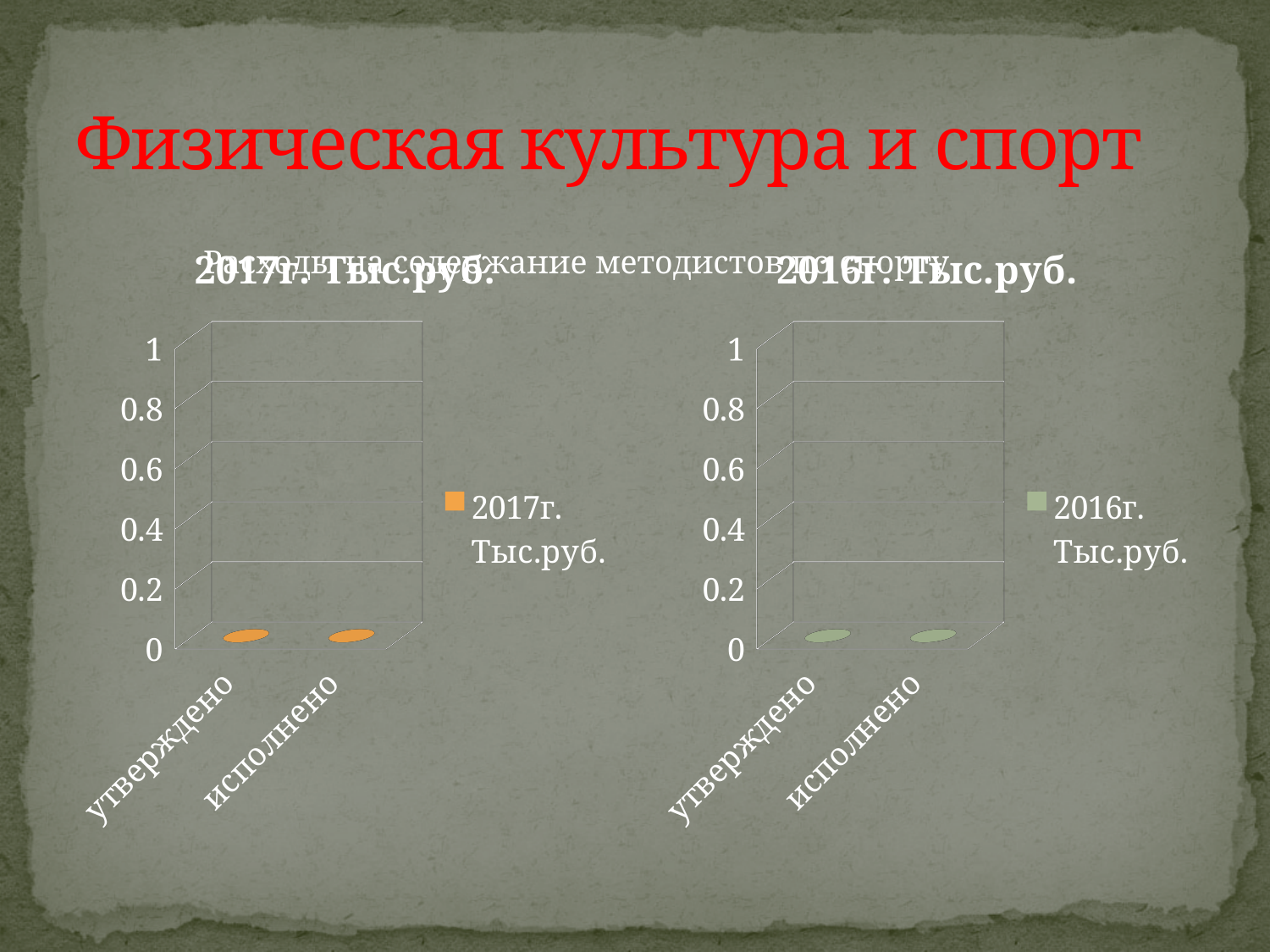
In the left chart (2017г. Тыс.руб.), what value does the bar for утверждено sit on? 0 In the left chart (2017г. Тыс.руб.), how many categories are shown on the x axis? 2 In the right chart (2016г. Тыс.руб.), is the value for исполнено greater or less than 0.2? less What kind of chart is the chart titled "2016г. Тыс.руб." on the right? bar chart How many series does the legend of the left chart (2017г. Тыс.руб.) list? 1 What kind of chart is the chart titled "2017г. Тыс.руб." on the left? bar chart What is the title of the chart on the right? 2016г. Тыс.руб. In the left chart (2017г. Тыс.руб.), is the value for утверждено greater or less than 0.2? less In the right chart (2016г. Тыс.руб.), what value does the bar for исполнено sit on? 0 What is the legend entry of the left chart? 2017г. Тыс.руб. In the right chart (2016г. Тыс.руб.), how many categories are shown on the x axis? 2 How many series does the legend of the right chart (2016г. Тыс.руб.) list? 1